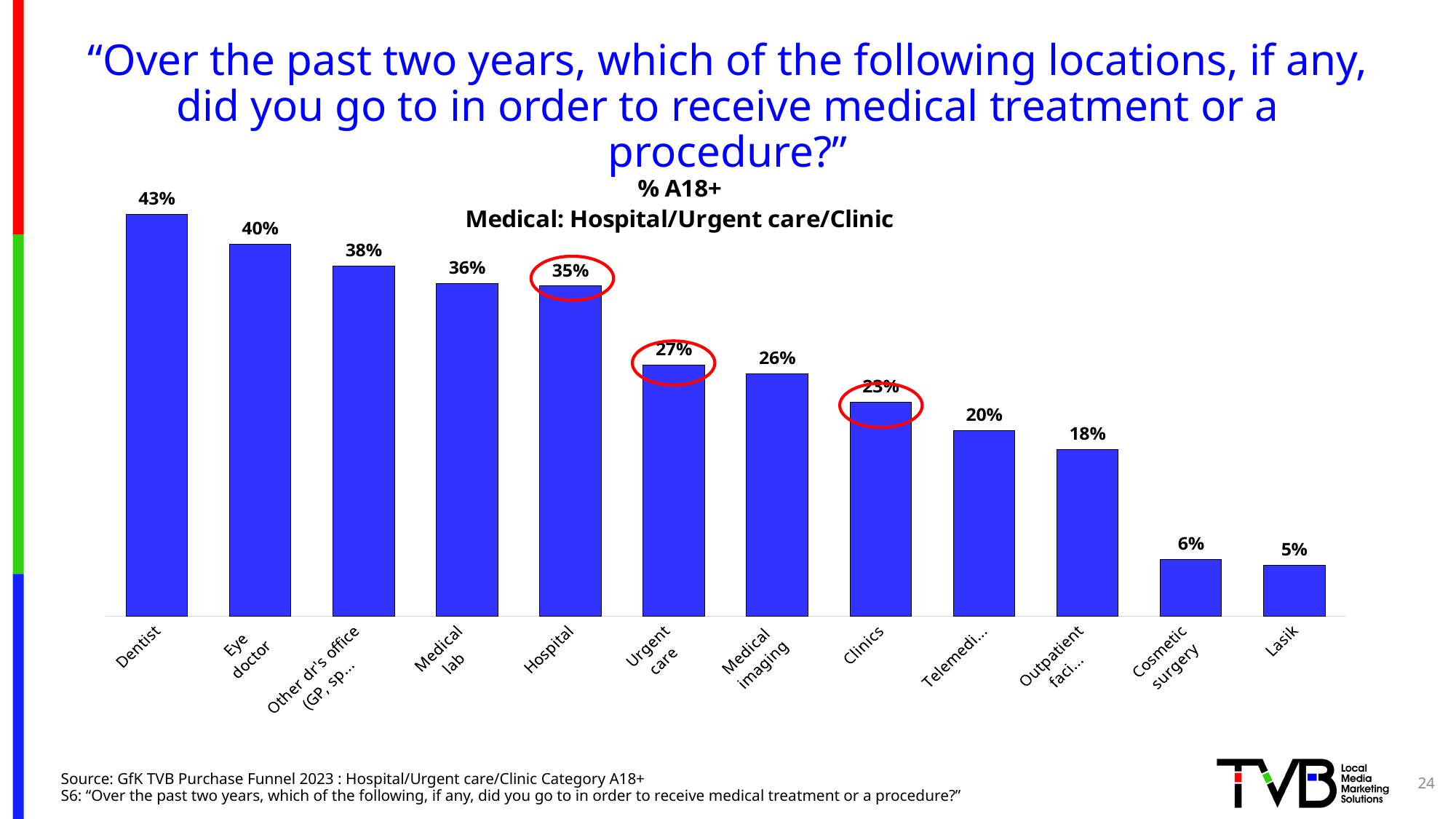
Which category has the highest value? Dentist What is the difference between the values for Hospital and Urgent care? 8 percentage points What kind of chart is shown on the slide? Bar chart What is the value for Dentist? 43% Do the values rise or fall from left to right along the x axis? Fall Which category has the lowest value? Lasik What is the value for Hospital? 35% Which is larger, the value for Medical lab or the value for Medical imaging? Medical lab What is the value for Cosmetic surgery? 6% How many categories are shown in the chart? 12 What is the value for Urgent care? 27% What is the difference between the values for Dentist and Eye doctor? 3 percentage points